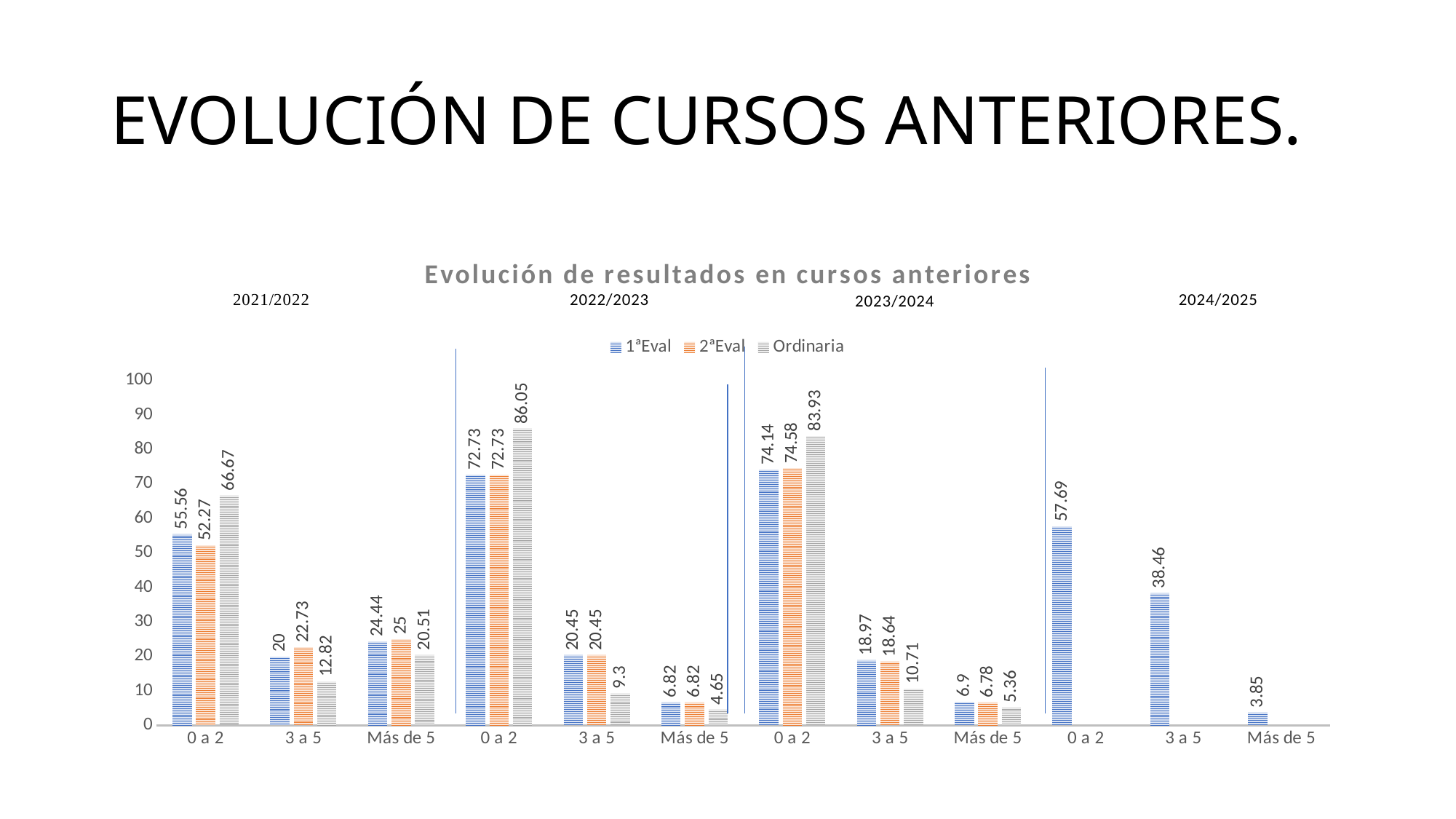
What is the Ordinaria value for '0 a 2' in 2022/2023? 86.05 What is the difference between the Ordinaria and 1ªEval values for '0 a 2' in 2021/2022? 11.11 What is the 2ªEval value for '3 a 5' in 2023/2024? 18.64 What kind of chart is shown on the slide? Bar chart How many series does the legend list? 3 What is the 1ªEval value for 'Más de 5' in 2024/2025? 3.85 Is the 1ªEval value for '0 a 2' in 2024/2025 greater or less than 50? greater What is the 1ªEval value for '0 a 2' in 2021/2022? 55.56 Which is larger for '3 a 5' in 2021/2022: the 2ªEval value or the Ordinaria value? 2ªEval Which bar in the chart has the lowest value? 1ªEval, Más de 5, 2024/2025 (3.85) Which bar in the chart has the highest value? Ordinaria, 0 a 2, 2022/2023 (86.05) What is the title of the chart? Evolución de resultados en cursos anteriores